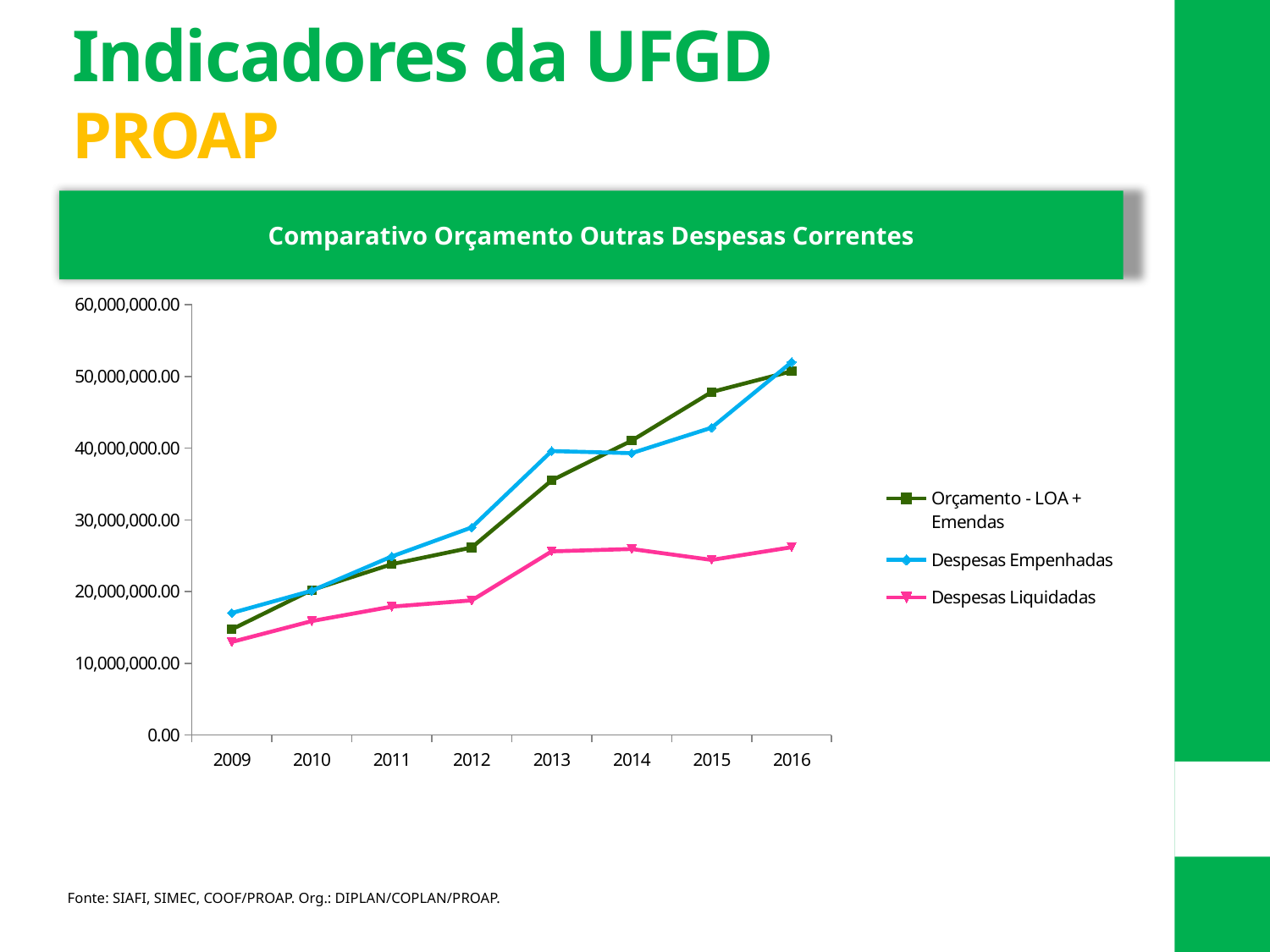
Is the value for Despesas Empenhadas in 2016 greater or less than 40,000,000.00? greater Is the value for Despesas Liquidadas in 2016 greater or less than 30,000,000.00? less In which year is Orçamento - LOA + Emendas lowest? 2009 Which series has the lowest value in 2016? Despesas Liquidadas How many series does the legend list? 3 Does the Orçamento - LOA + Emendas series rise or fall from 2009 to 2016? rise Is the value for Orçamento - LOA + Emendas in 2009 greater or less than 20,000,000.00? less What is the title of the chart? Comparativo Orçamento Outras Despesas Correntes In 2015, which is larger: Orçamento - LOA + Emendas or Despesas Empenhadas? Orçamento - LOA + Emendas How many years are shown on the x axis? 8 What kind of chart is shown on the slide? line chart